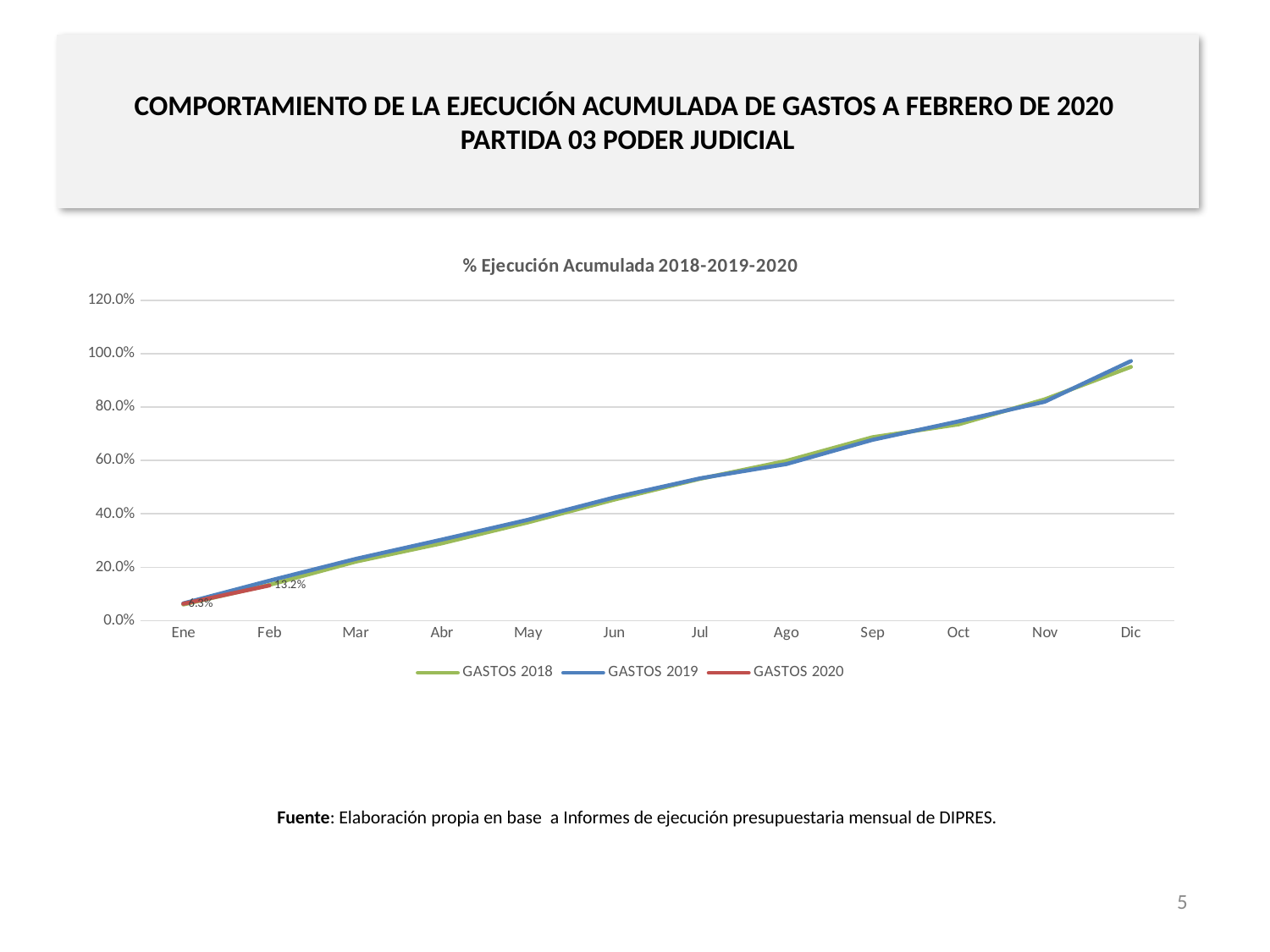
What is the title of the chart? % Ejecución Acumulada 2018-2019-2020 How many months are shown on the x axis? 12 Do the values for GASTOS 2019 rise or fall from Ene to Dic? rise Is the value for GASTOS 2018 in Jun greater or less than 60.0%? less Is the value for GASTOS 2019 in Ago greater or less than 40.0%? greater Is the value for GASTOS 2019 in Dic greater or less than 80.0%? greater What kind of chart is shown on the slide? line chart What is the value for GASTOS 2020 in Feb? 13.2% How many series does the legend list? 3 Which series is drawn in red? GASTOS 2020